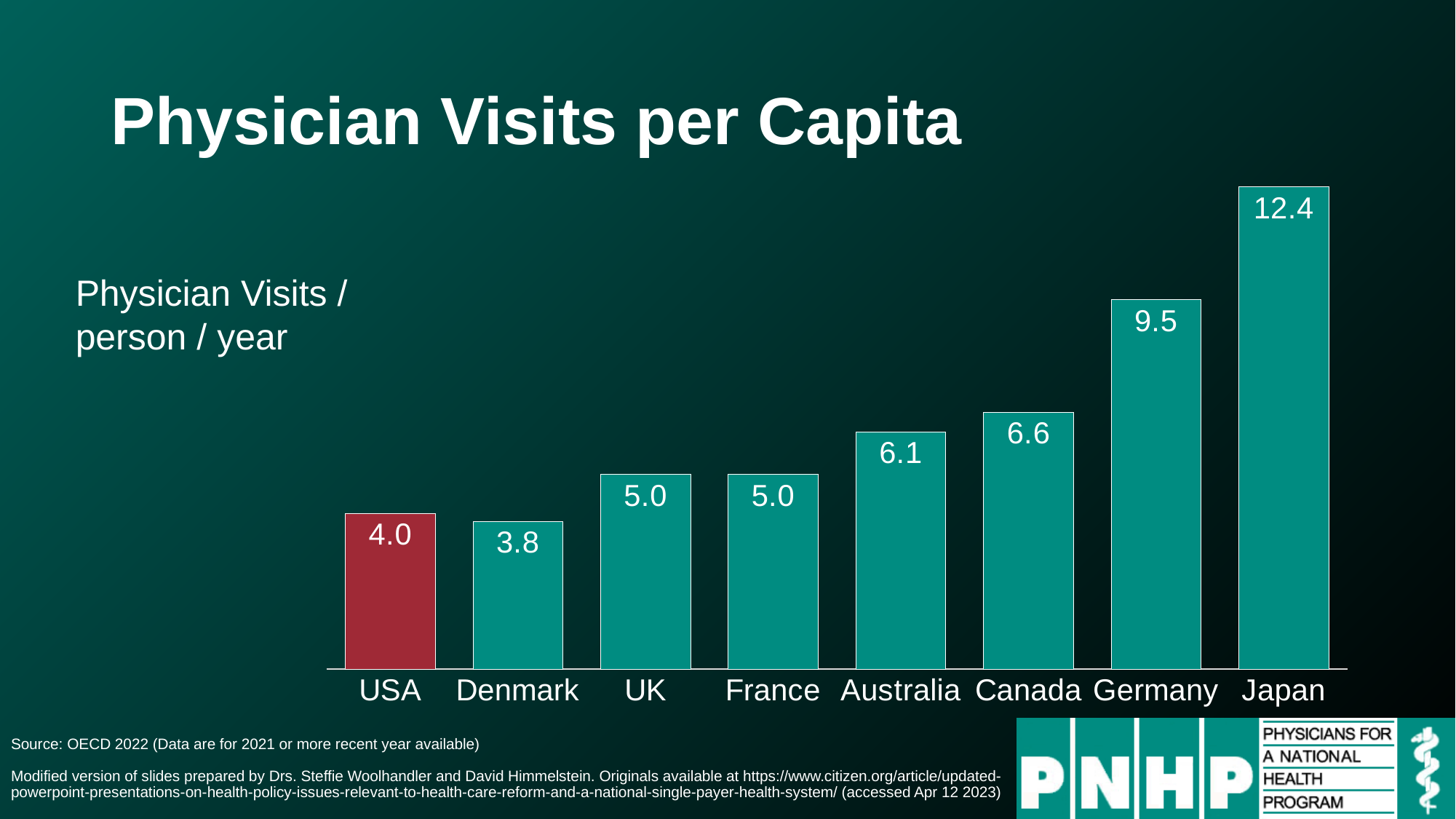
Which has a higher value, Australia or France? Australia What is the value for Germany? 9.5 Which country has the highest number of physician visits per capita? Japan What is the value for Japan? 12.4 Which country has the lowest number of physician visits per capita? Denmark Which country's bar is shown in a different colour (red) from the others? USA What is the value for Canada? 6.6 What is the value for the USA? 4.0 How many countries are shown in the chart? 8 What is the difference between the values for Germany and Canada? 2.9 What kind of chart is shown on the slide? Bar chart What is the difference between the values for Japan and the USA? 8.4